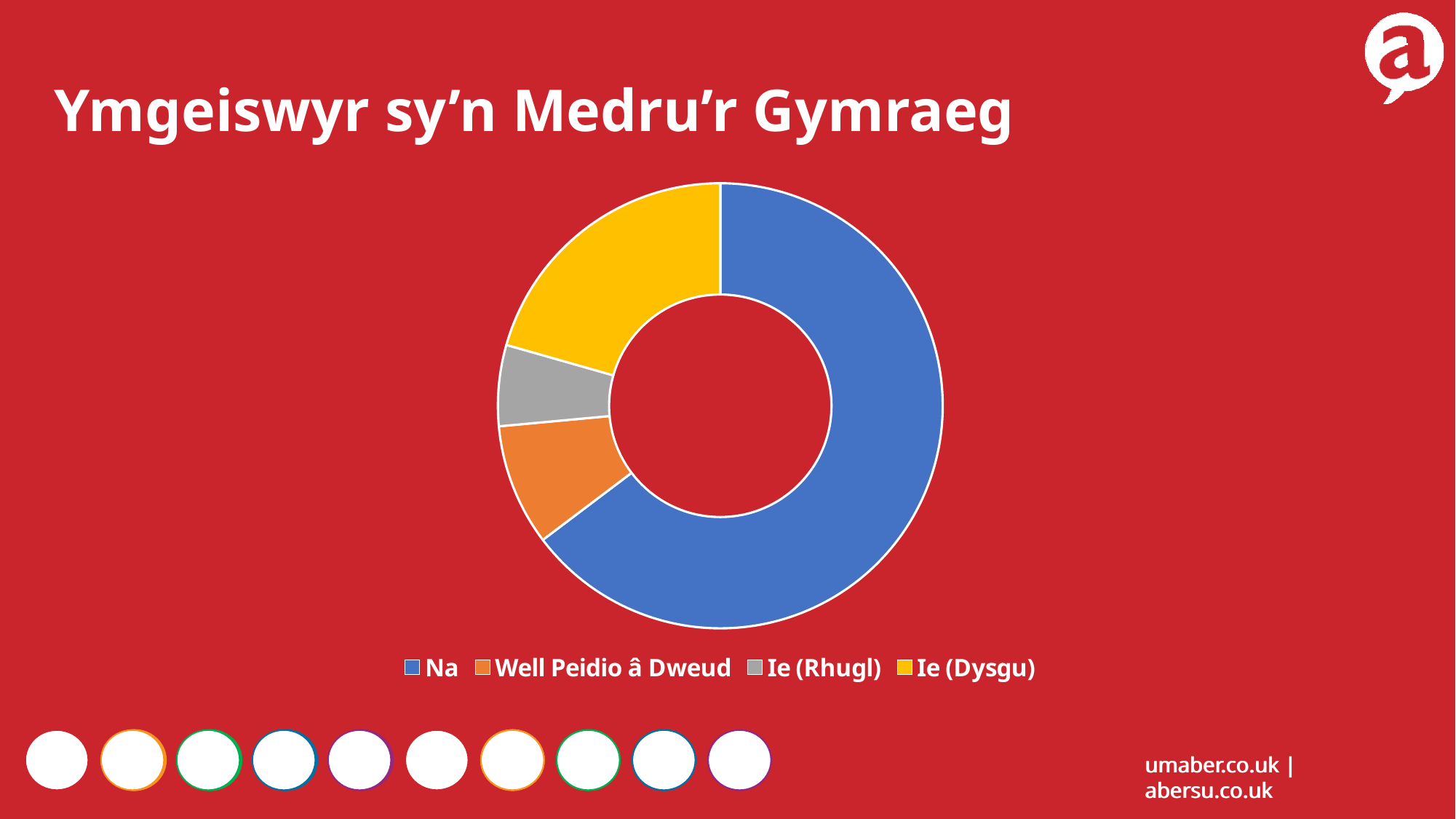
What is the title of the slide containing the chart? Ymgeiswyr sy’n Medru’r Gymraeg Which category has the largest slice in the chart? Na How many categories does the legend of the chart list? 4 What kind of chart is shown on the slide? Doughnut chart Does the Na slice take up more or less than half of the chart? More Which slice is larger, Na or Ie (Dysgu)? Na Which slice is larger, Ie (Dysgu) or Well Peidio â Dweud? Ie (Dysgu) Which category has the smallest slice in the chart? Ie (Rhugl) What colour is the slice for Ie (Dysgu)? Yellow